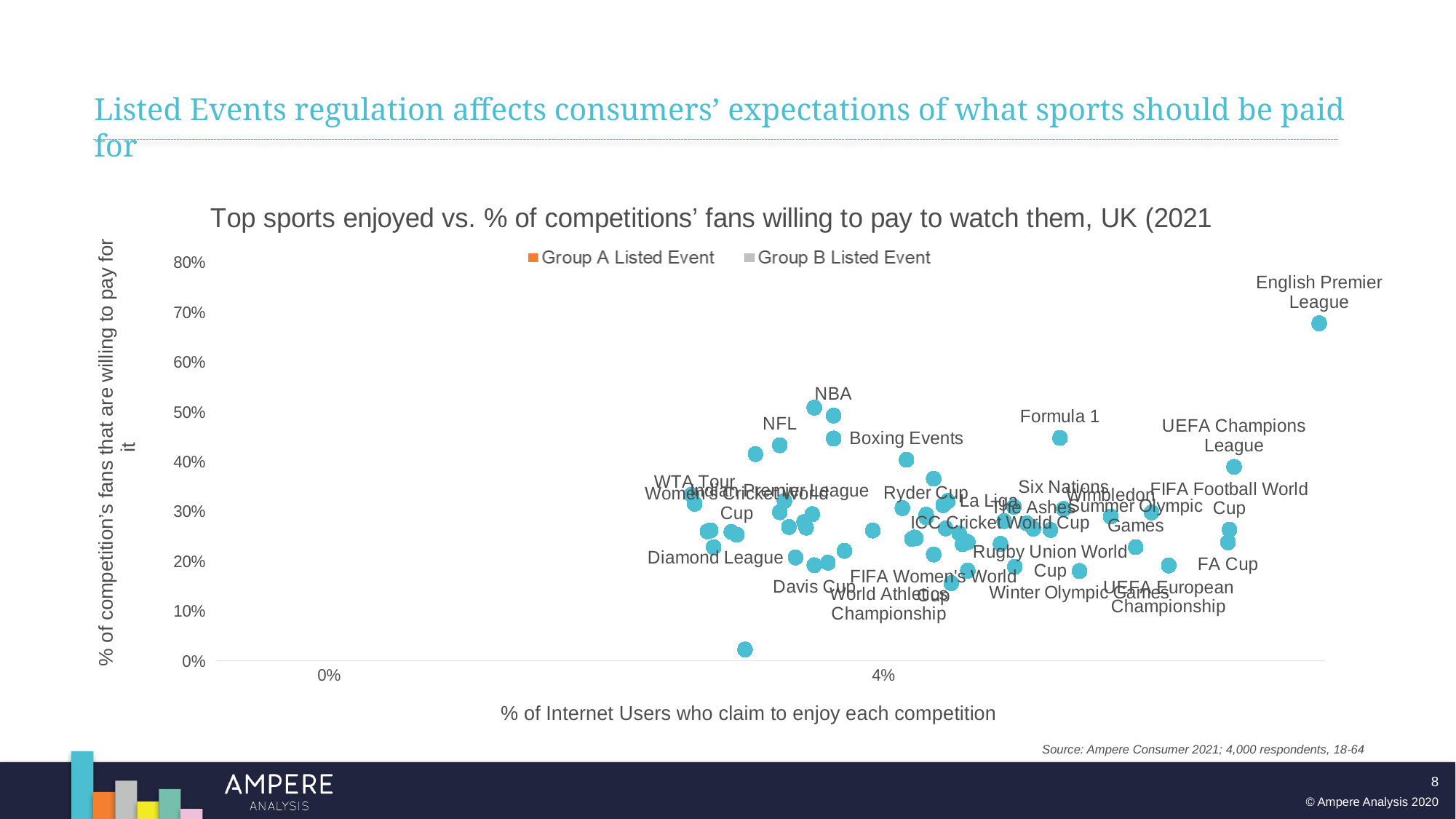
What kind of chart is shown on the slide? Scatter chart Which has a higher percentage of fans willing to pay: Formula 1 or the FA Cup? Formula 1 Is the percentage of fans willing to pay for the FA Cup greater or less than 30%? less Is the percentage of fans willing to pay for the UEFA Champions League greater or less than 30%? greater What is the label of the chart's x axis? % of Internet Users who claim to enjoy each competition How many series does the chart legend list? 2 Is the percentage of fans willing to pay for the Diamond League greater or less than 30%? less Which has a higher percentage of fans willing to pay: the English Premier League or the NBA? English Premier League Which competition has the highest percentage of fans willing to pay to watch it? English Premier League